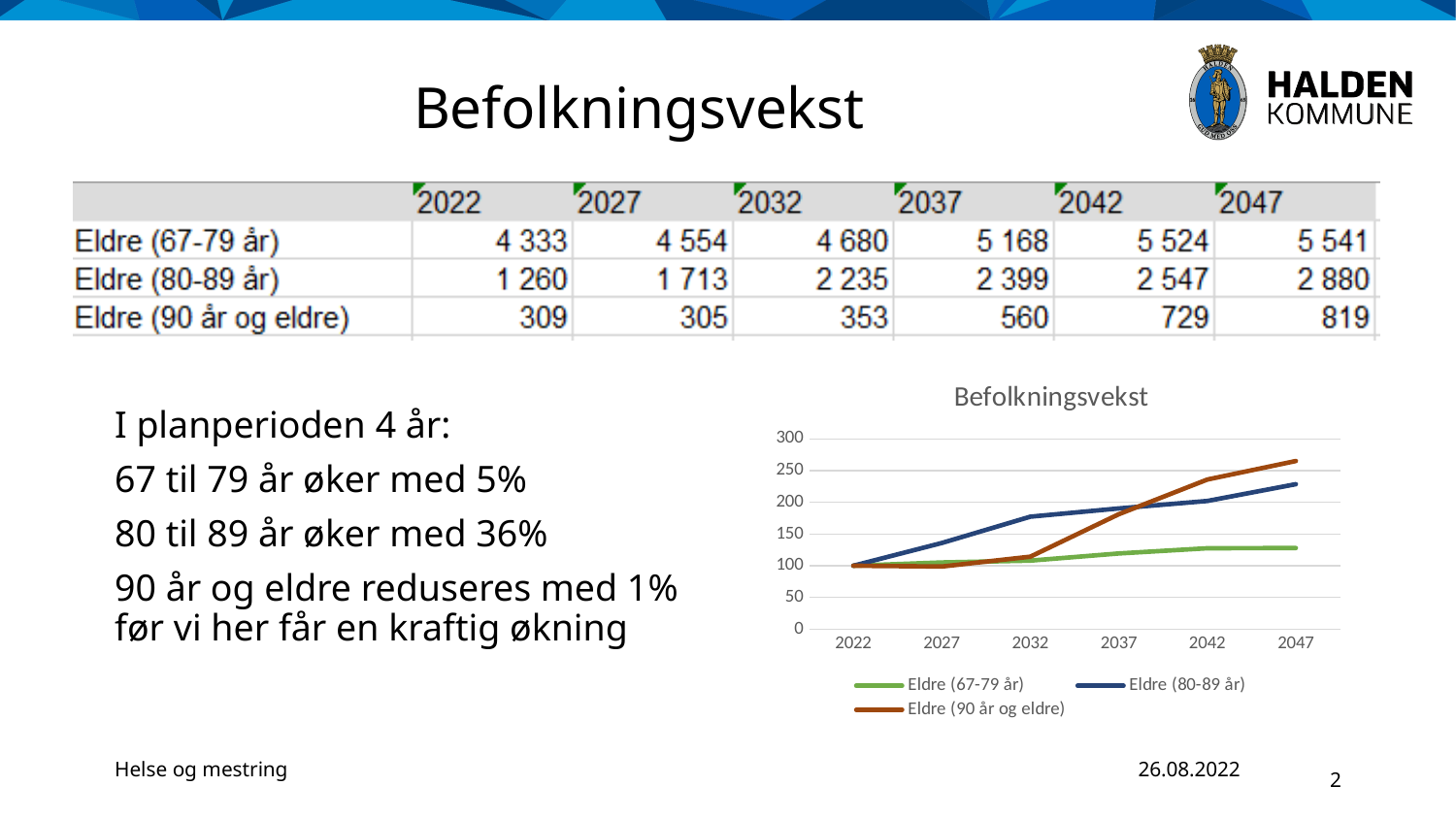
How many years are plotted along the x axis of the chart? 6 How many series does the chart's legend list? 3 Is the value for Eldre (80-89 år) in 2032 greater or less than 150? greater Which series has the highest value in 2047? Eldre (90 år og eldre) Is the value for Eldre (67-79 år) in 2047 greater or less than 150? less What kind of chart is shown on the slide? line chart Is the value for Eldre (90 år og eldre) in 2047 greater or less than 250? greater In 2042, which is larger: Eldre (90 år og eldre) or Eldre (80-89 år)? Eldre (90 år og eldre) Which series has the lowest value in 2047? Eldre (67-79 år) In 2032, which is larger: Eldre (80-89 år) or Eldre (90 år og eldre)? Eldre (80-89 år) Does the Eldre (80-89 år) line rise or fall from 2022 to 2047? rise What is the title of the chart? Befolkningsvekst